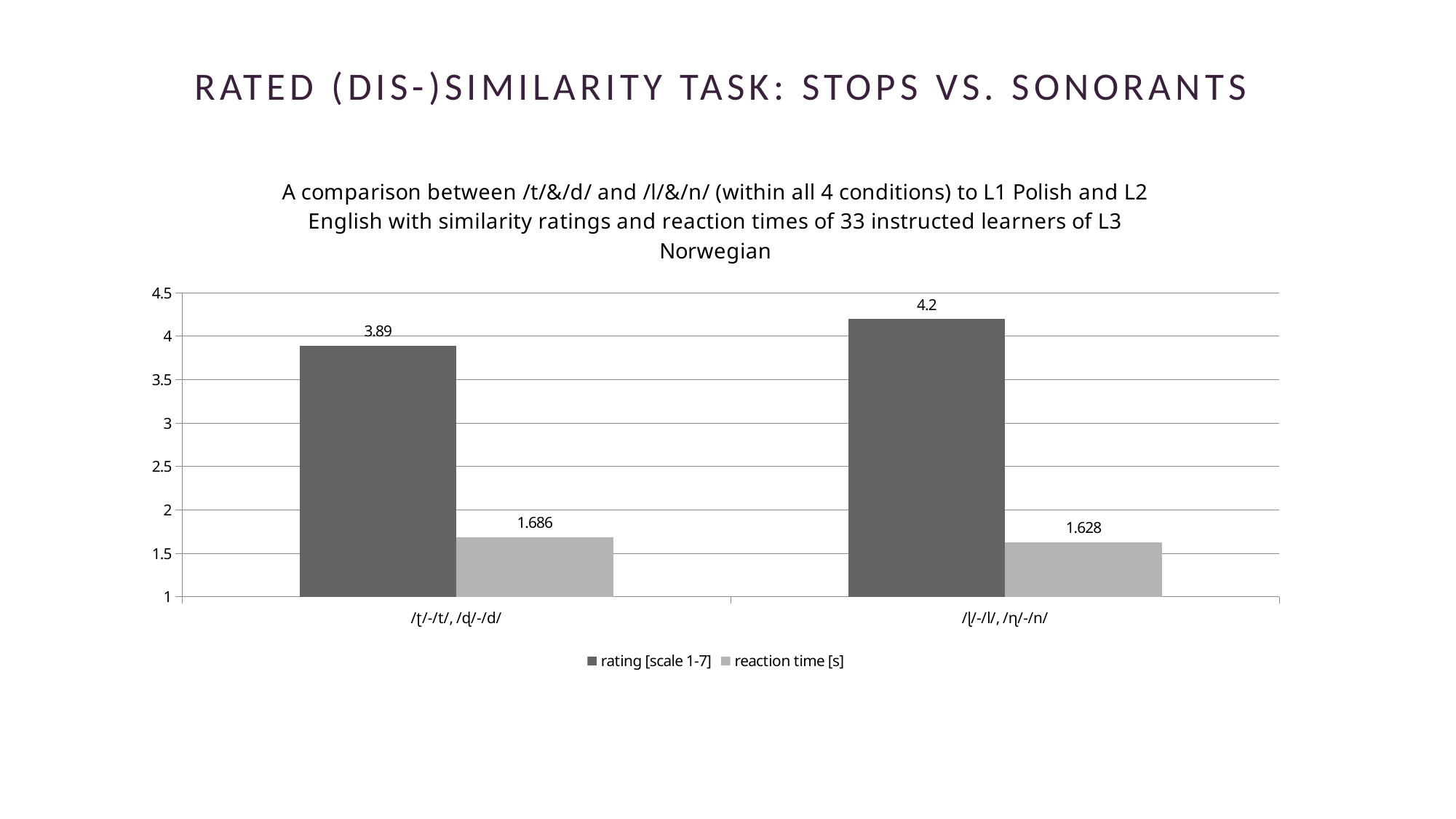
How many series does the legend list? 2 What is the reaction time [s] for the second category (/ɭ/-/l/, /ɳ/-/n/)? 1.628 Which category has the lower reaction time [s]? /ɭ/-/l/, /ɳ/-/n/ What is the reaction time [s] for the first category (/ʈ/-/t/, /ɖ/-/d/)? 1.686 Which category has the higher rating [scale 1-7]? /ɭ/-/l/, /ɳ/-/n/ What is the difference between the rating values of the two categories? 0.31 What is the rating [scale 1-7] value for the first category (/ʈ/-/t/, /ɖ/-/d/)? 3.89 Is the rating for the first category (/ʈ/-/t/, /ɖ/-/d/) greater or less than 4? less What kind of chart is shown on the slide? bar chart How many categories are shown on the x axis? 2 What is the difference between the reaction times of the two categories? 0.058 What is the rating [scale 1-7] value for the second category (/ɭ/-/l/, /ɳ/-/n/)? 4.2